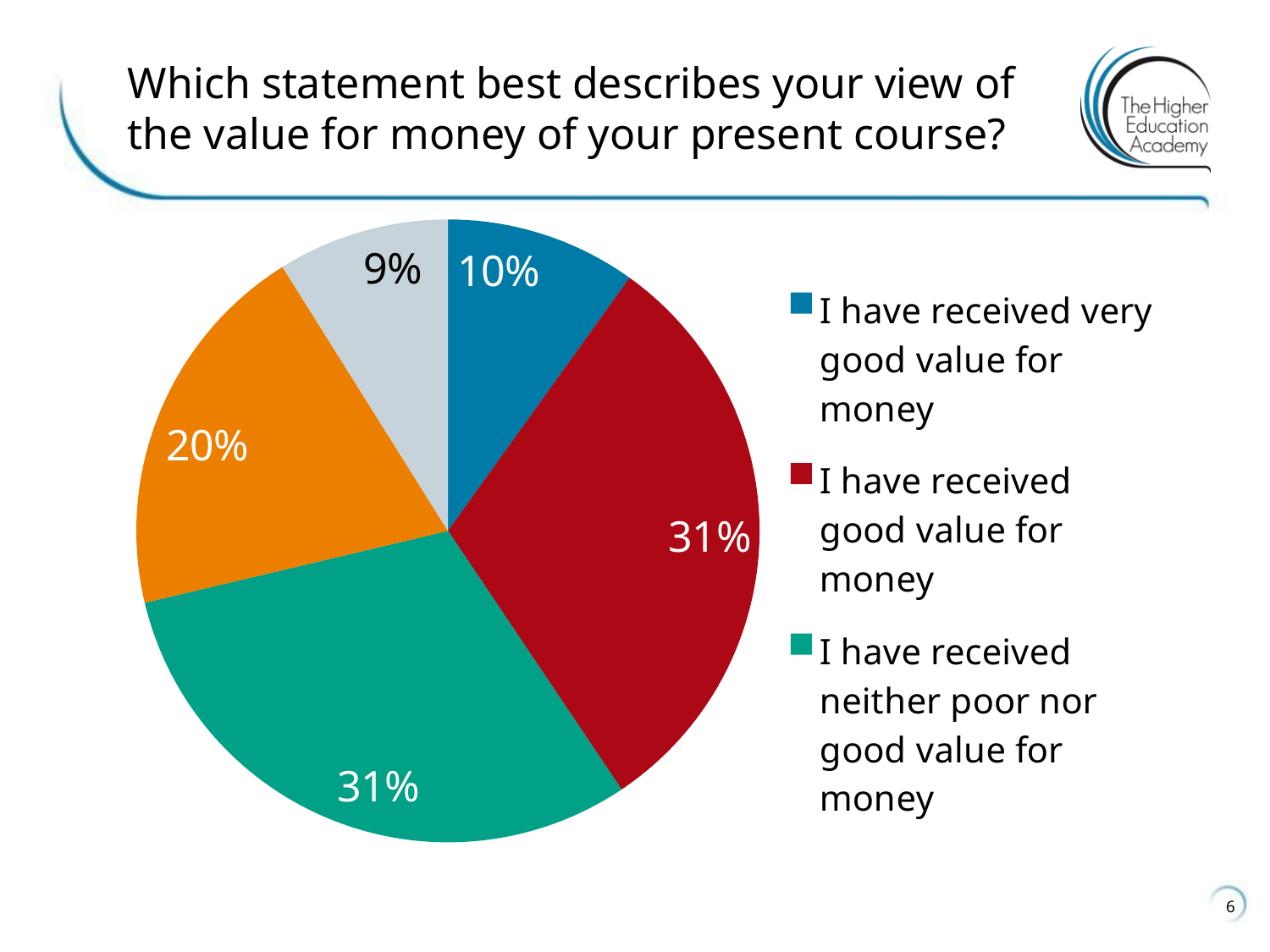
How many slices does the pie chart have? 5 Which is larger: the share for "I have received good value for money" or the share for "I have received very good value for money"? I have received good value for money Is the orange slice larger or smaller than the blue slice? larger What percentage of respondents said "I have received very good value for money"? 10% What is the difference between the share for "I have received good value for money" and the share for "I have received very good value for money"? 21% What is the value of the smallest slice in the pie chart? 9% What is the combined share of "I have received very good value for money" and "I have received good value for money"? 41% What colour is the slice for "I have received neither poor nor good value for money"? green What colour is the slice for "I have received very good value for money"? blue What percentage of respondents said "I have received good value for money"? 31% What share of the pie is "I have received neither poor nor good value for money"? 31% What kind of chart is shown on the slide? pie chart